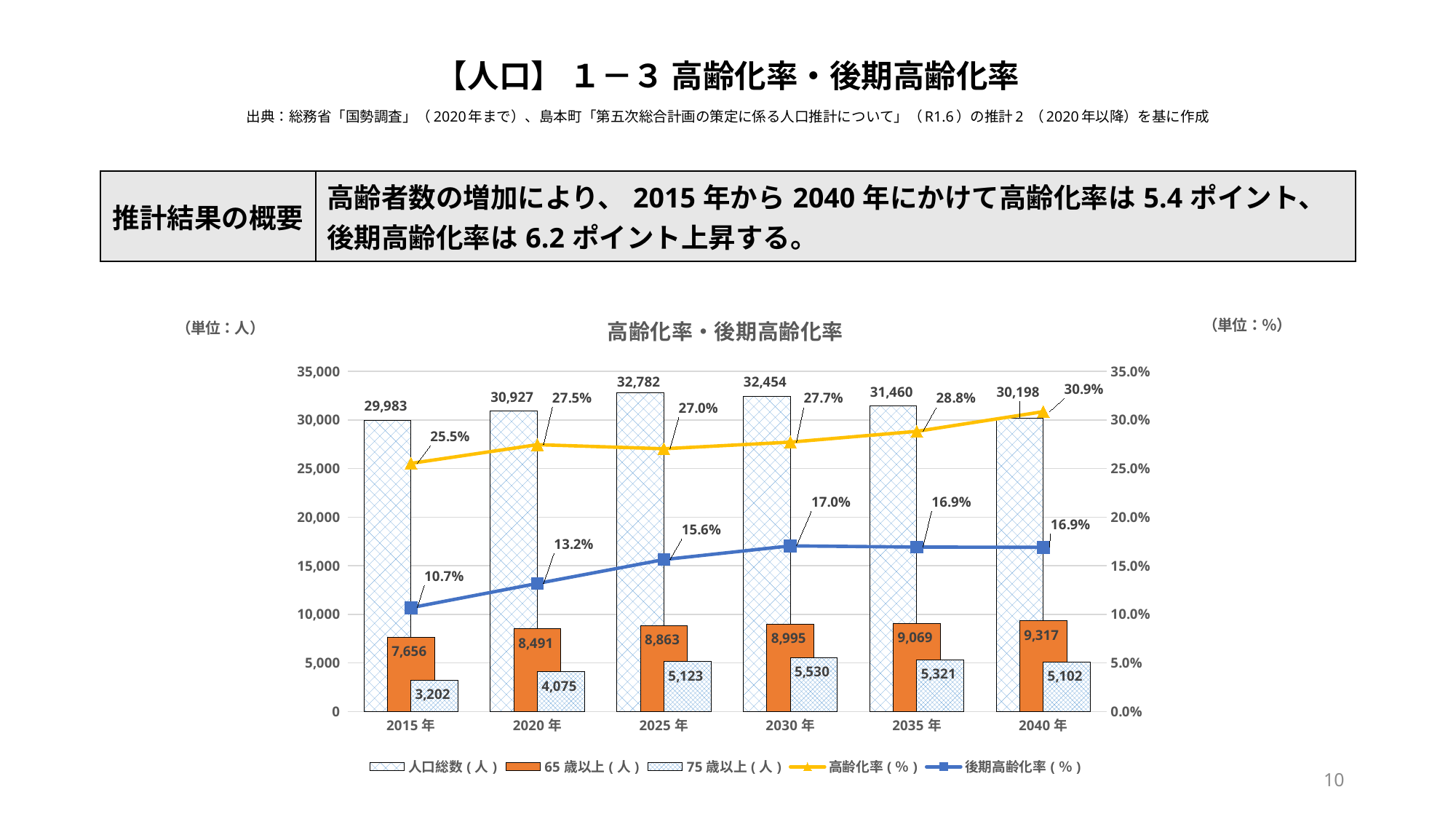
In which year is 人口総数 (人) highest? 2025年 How many series does the legend list? 5 In which year is 後期高齢化率 (%) lowest? 2015年 What is the 高齢化率 (%) for 2040年? 30.9% What is the value of 人口総数 (人) for 2025年? 32,782 What kind of chart is this? Combined bar and line chart How many years are shown on the x axis? 6 What is the value of 75歳以上 (人) for 2030年? 5,530 Is the value of 人口総数 (人) for 2015年 greater or less than 30,000? less What is the difference between 65歳以上 (人) in 2040年 and in 2015年? 1,661 Does 65歳以上 (人) rise or fall from 2015年 to 2040年? rise Which is larger, 75歳以上 (人) in 2035年 or in 2040年? 2035年